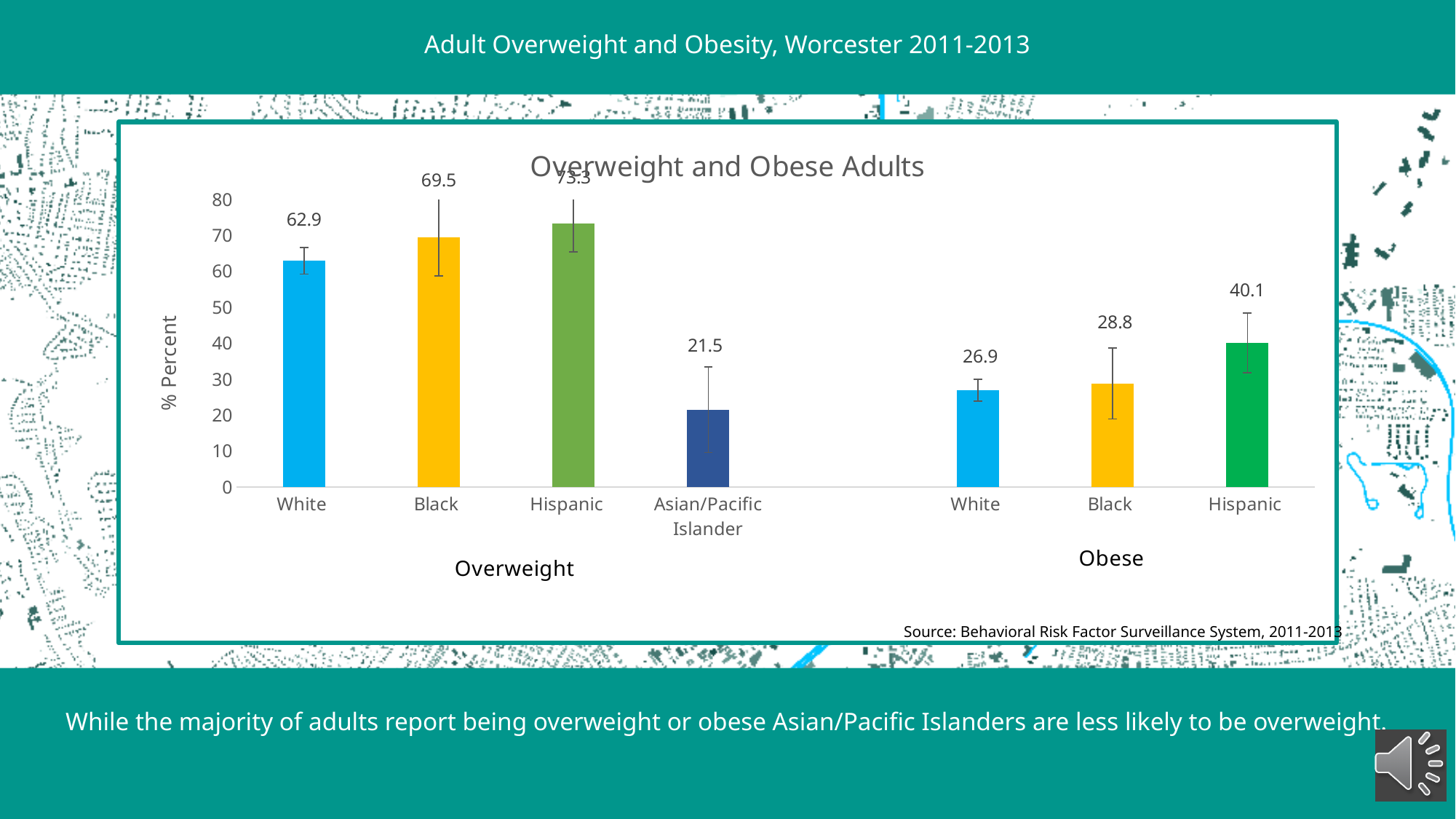
Which group has the highest obese percentage? Hispanic Which group has the highest overweight percentage? Hispanic What is the difference between the overweight percentages for Black and White adults? 6.6 How many bars are shown in the Overweight group? 4 Which is larger, the overweight percentage for Hispanic adults or for Black adults? Hispanic What is the overweight percentage for Asian/Pacific Islander adults? 21.5 What is the obese percentage for Hispanic adults? 40.1 What is the obese percentage for Black adults? 28.8 What type of chart is shown on the slide? Bar chart What is the difference between the obese percentages for Hispanic and White adults? 13.2 Which group has the lowest overweight percentage? Asian/Pacific Islander What is the overweight percentage for White adults? 62.9